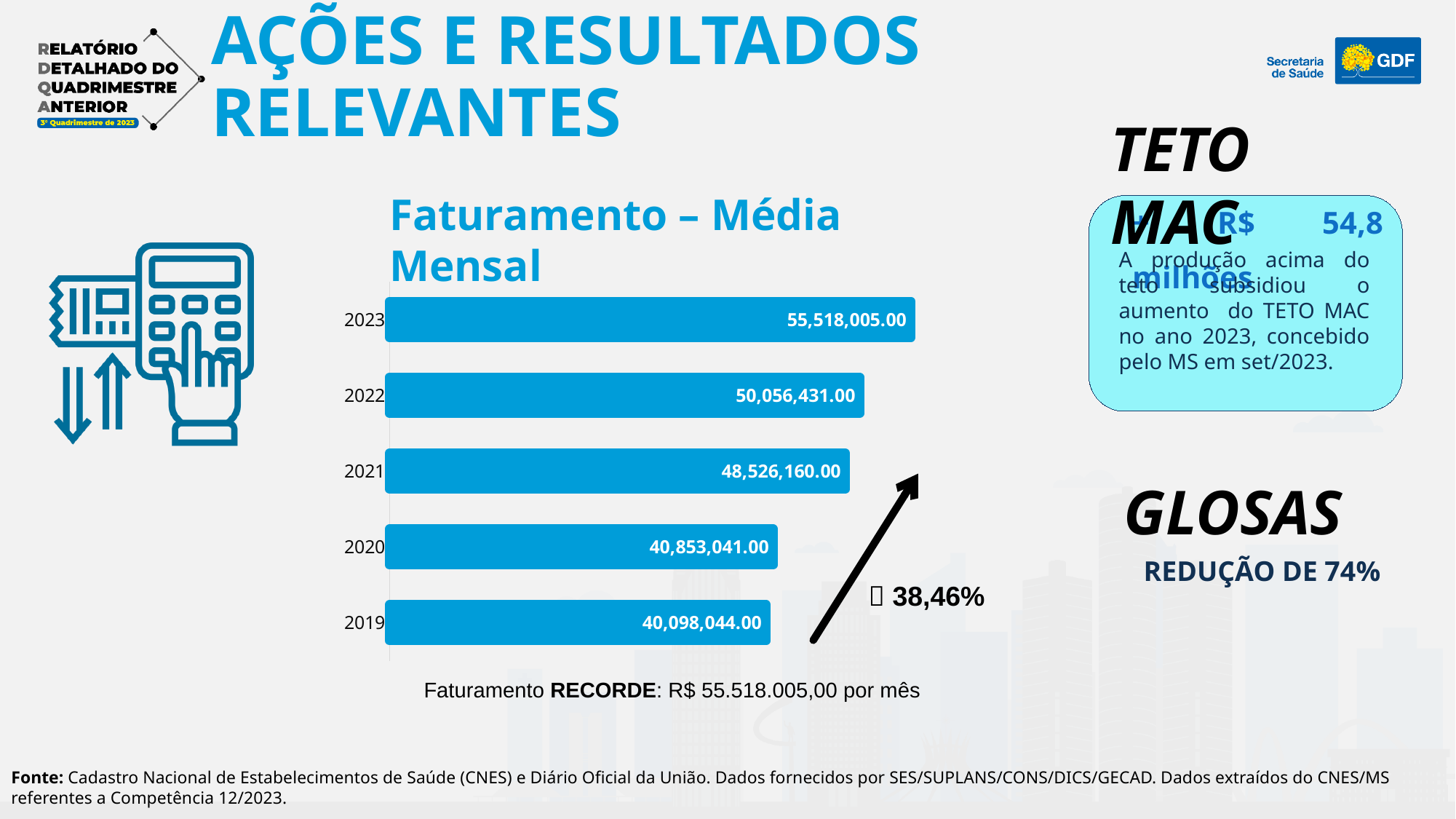
What is the value for 2019 in the Faturamento – Média Mensal chart? 40,098,044.00 Which year has the lowest value in the Faturamento – Média Mensal chart? 2019 Which year has the highest value in the Faturamento – Média Mensal chart? 2023 What is the difference between the 2020 and 2019 values in the Faturamento – Média Mensal chart? 754,997.00 What is the value for 2021 in the Faturamento – Média Mensal chart? 48,526,160.00 What is the difference between the 2023 and 2022 values in the Faturamento – Média Mensal chart? 5,461,574.00 In the Faturamento – Média Mensal chart, which is larger, the value for 2022 or the value for 2021? 2022 What kind of chart is the Faturamento – Média Mensal chart? bar chart Do the values in the Faturamento – Média Mensal chart rise or fall from 2019 to 2023? rise What is the value for 2020 in the Faturamento – Média Mensal chart? 40,853,041.00 What is the value for 2023 in the Faturamento – Média Mensal chart? 55,518,005.00 How many years are shown in the Faturamento – Média Mensal chart? 5